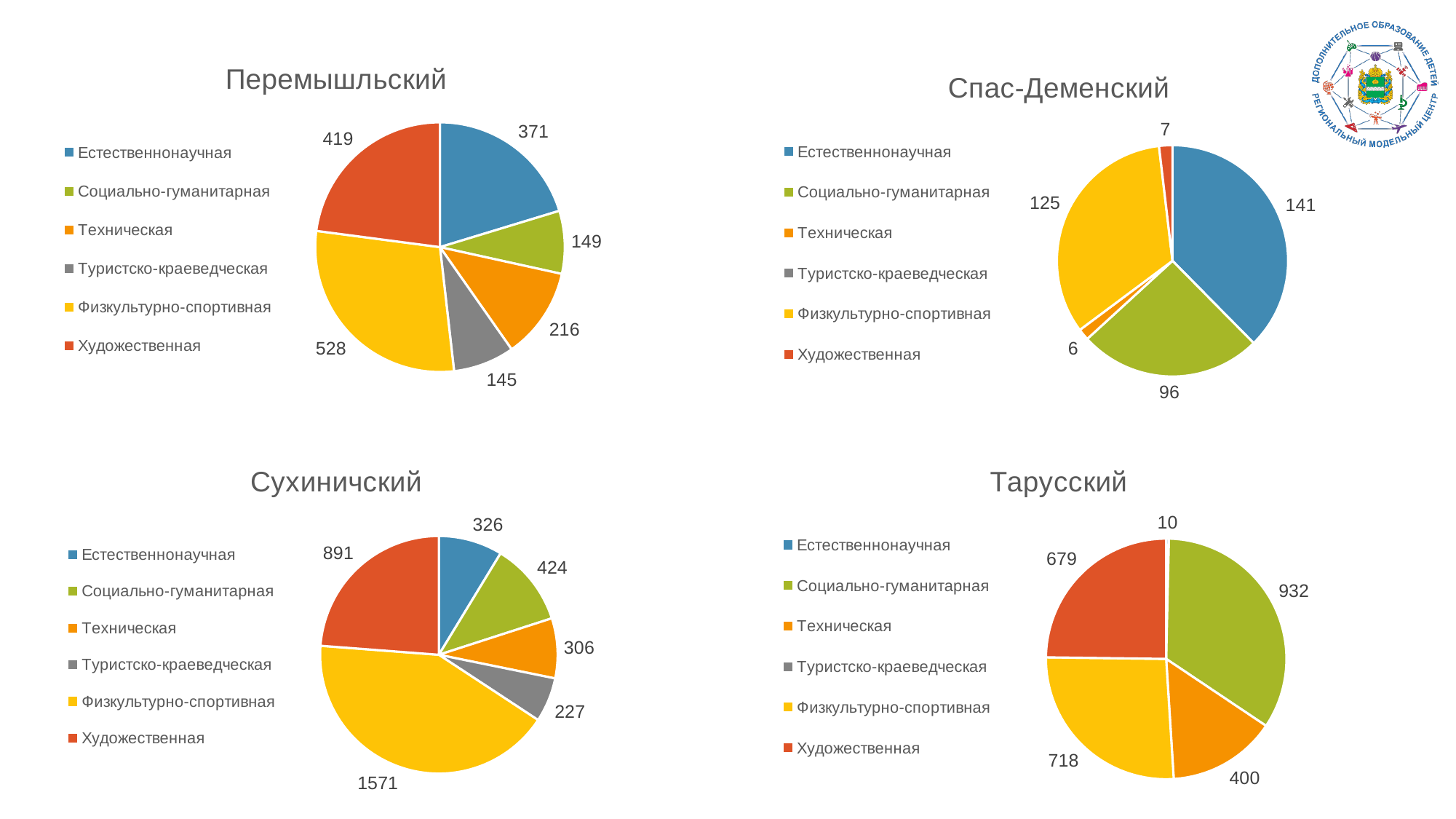
In the Тарусский chart, what is the value for Социально-гуманитарная? 932 In the Сухиничский chart, what is the difference between Физкультурно-спортивная and Художественная? 680 In the Сухиничский chart, which category has the highest value? Физкультурно-спортивная What type of chart is used for Тарусский? Pie chart In the Тарусский chart, which is larger, Физкультурно-спортивная or Художественная? Физкультурно-спортивная In the Спас-Деменский chart, what is the value for Техническая? 6 In the Спас-Деменский chart, which is larger, Социально-гуманитарная or Физкультурно-спортивная? Физкультурно-спортивная In the Перемышльский chart, what is the difference between Художественная and Естественнонаучная? 48 In the Перемышльский chart, what is the value for Физкультурно-спортивная? 528 In the Спас-Деменский chart, what is the value for Естественнонаучная? 141 In the Сухиничский chart, what is the value for Туристско-краеведческая? 227 In the Перемышльский chart, which category has the lowest value? Туристско-краеведческая